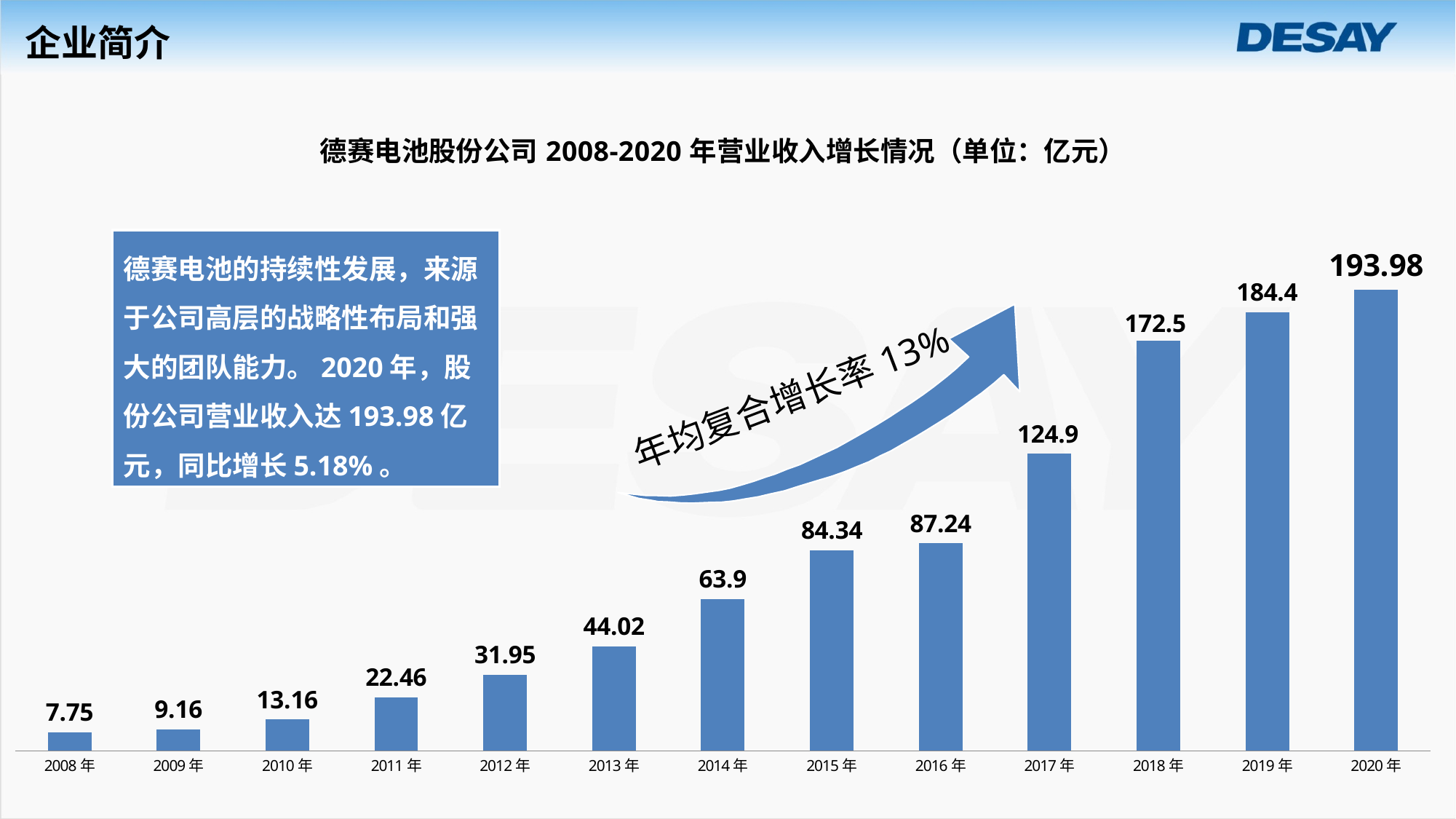
What annual compound growth rate is written on the arrow over the chart? 13% What is the revenue value shown for 2014 年? 63.9 Which year has the highest revenue in the chart? 2020 年 Do the revenue values rise or fall from 2008 年 to 2020 年? Rise What kind of chart is shown on the slide? Bar chart What is the revenue value shown for 2017 年? 124.9 What is the revenue value shown for 2008 年? 7.75 How many years are shown on the x axis of the chart? 13 What is the difference between the revenue for 2016 年 and 2015 年? 2.9 What is the difference between the revenue for 2020 年 and 2019 年? 9.58 Which year has the lowest revenue in the chart? 2008 年 Which is larger, the revenue for 2012 年 or 2013 年? 2013 年